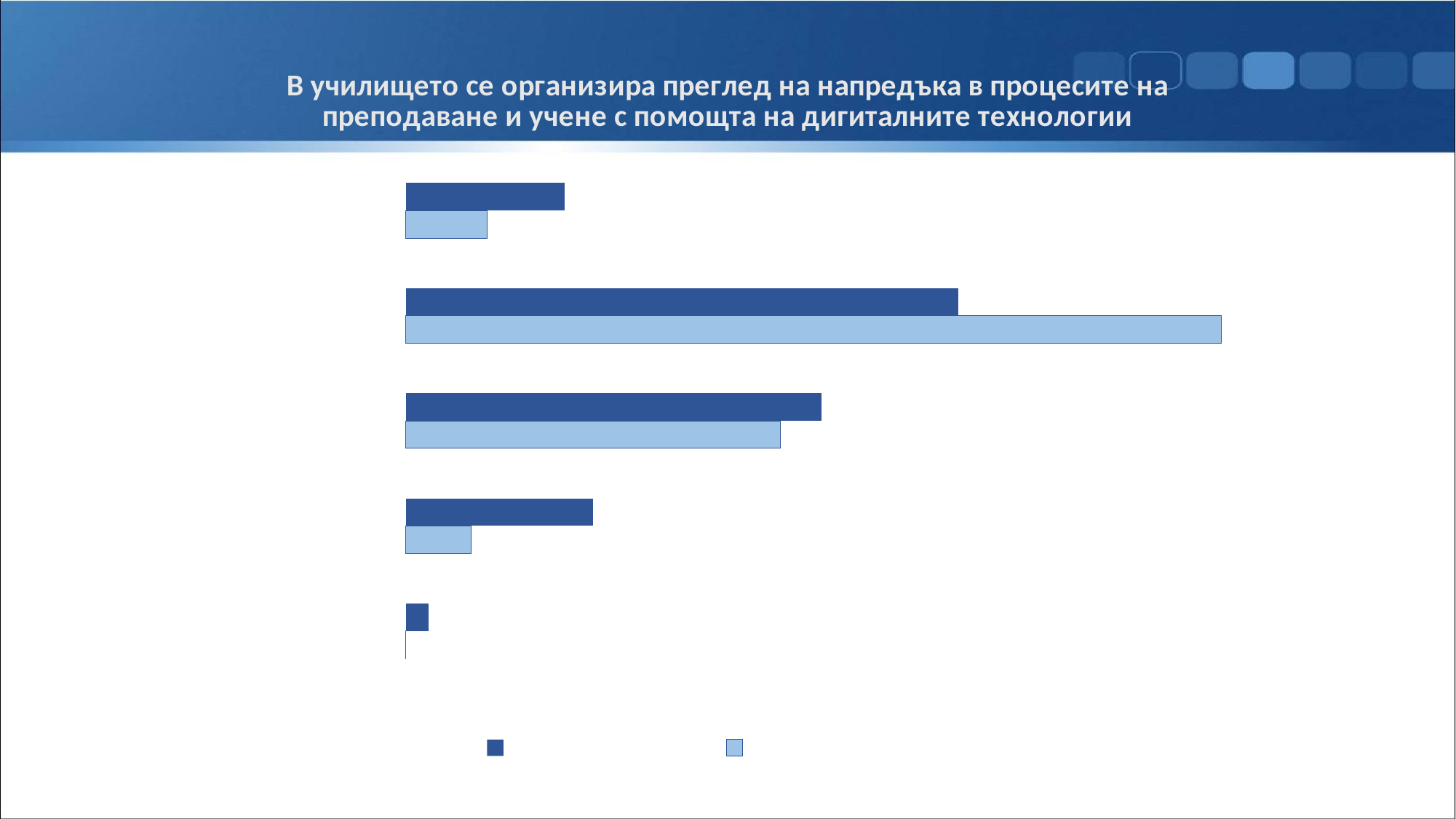
In the second group of bars from the top, which bar is longer, the dark blue one or the light blue one? the light blue one What two colours are used for the series in the chart? dark blue and light blue Which group of bars, counted from the top, contains the longest bar in the chart? the second group What kind of chart is shown on the slide? bar chart How many series does the legend show? 2 In the top group of bars, which bar is longer, the dark blue one or the light blue one? the dark blue one What is the title of the slide containing the chart? В училището се организира преглед на напредъка в процесите на преподаване и учене с помощта на дигиталните технологии How many groups of bars are plotted in the chart? 5 Which group of bars, counted from the top, has the shortest dark blue bar? the fifth group